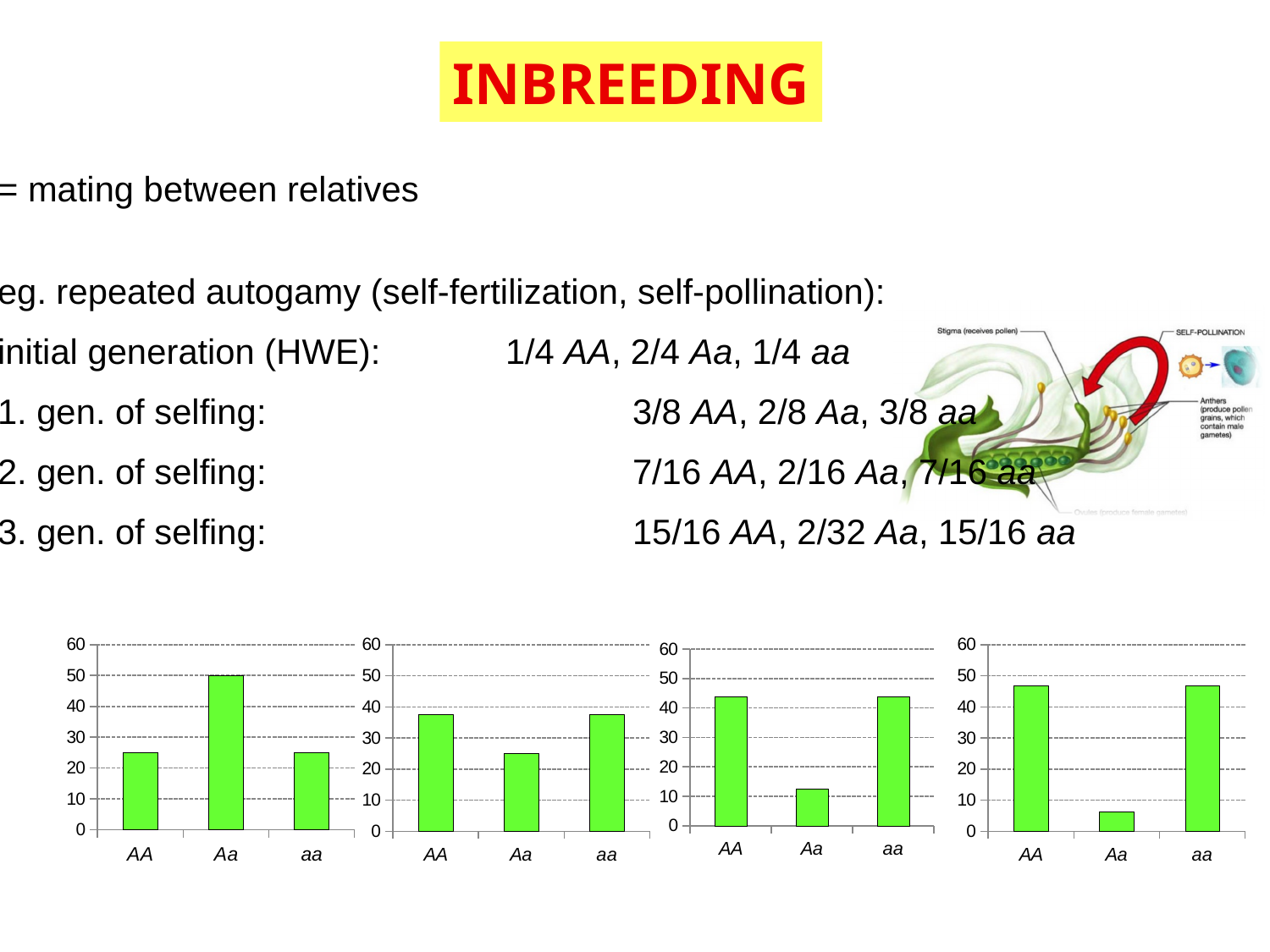
How many categories are shown on the x axis of the leftmost chart? 3 In the third chart from the left, is the value for Aa greater or less than 20? less In the rightmost chart, is the value for Aa greater or less than 10? less What kind of chart is the rightmost chart? bar chart In the second chart from the left, is the value for Aa greater or less than 30? less In the rightmost chart, which category has the lowest value? Aa In the leftmost chart, which category has the highest value? Aa In the leftmost chart, what is the value for Aa? 50 In the second chart from the left, which category has the lowest value? Aa